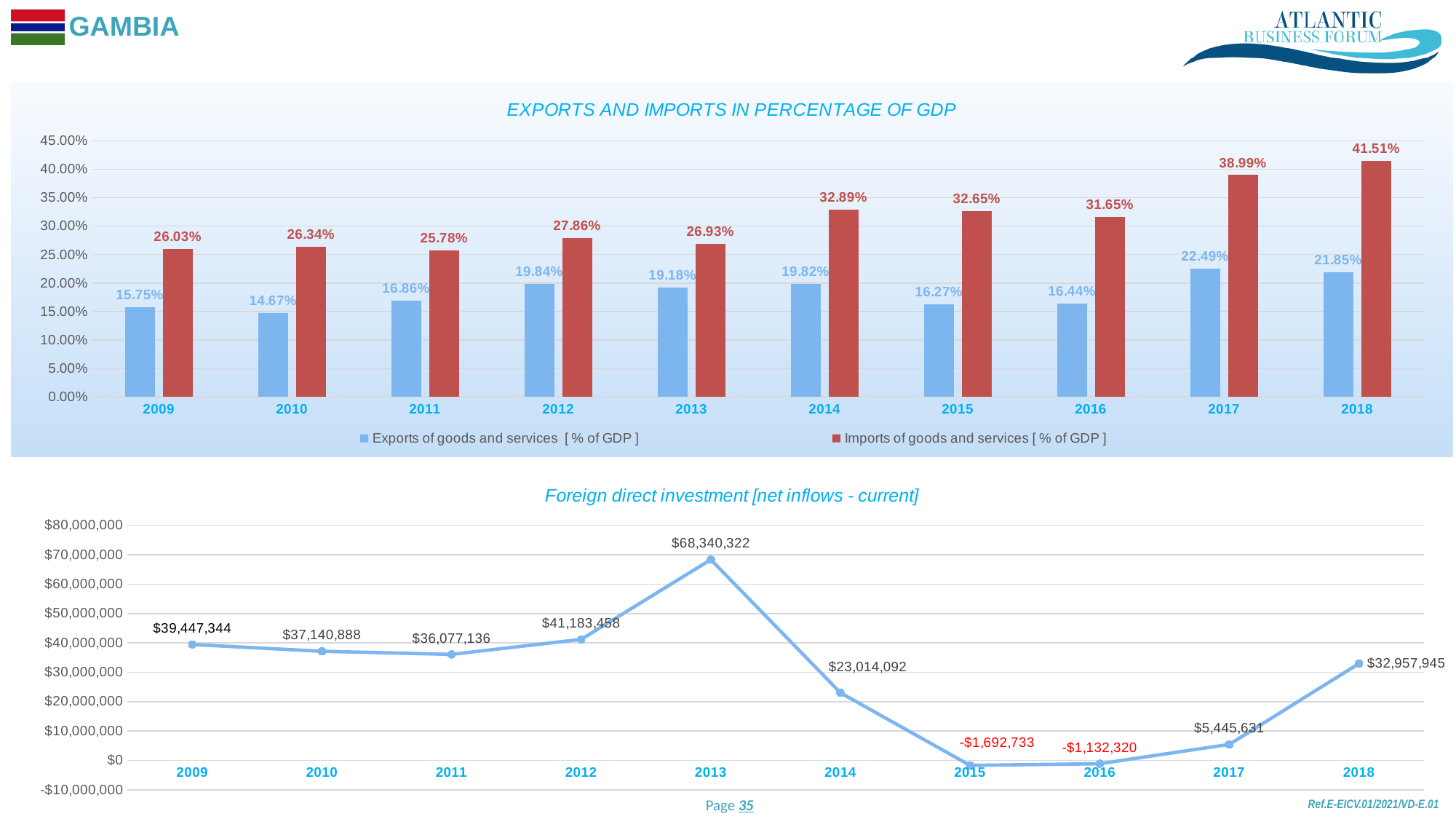
In the 'Exports and Imports in Percentage of GDP' chart, what is the value of imports of goods and services in 2017? 38.99% In the 'Foreign direct investment [net inflows - current]' chart, what is the value for 2013? $68,340,322 In the 'Foreign direct investment [net inflows - current]' chart, which year has the lowest value? 2015 In the 'Exports and Imports in Percentage of GDP' chart, which year has the highest imports value? 2018 What kind of chart is the 'Foreign direct investment [net inflows - current]' chart? Line chart In the 'Foreign direct investment [net inflows - current]' chart, is the value for 2014 larger or smaller than the value for 2018? Smaller In the 'Exports and Imports in Percentage of GDP' chart, how many series does the legend list? 2 In the 'Exports and Imports in Percentage of GDP' chart, what is the value of exports of goods and services in 2012? 19.84% In the 'Foreign direct investment [net inflows - current]' chart, how many years are plotted? 10 In the 'Exports and Imports in Percentage of GDP' chart, what is the difference between imports and exports in 2018? 19.66% What kind of chart is the 'Exports and Imports in Percentage of GDP' chart? Bar chart In the 'Exports and Imports in Percentage of GDP' chart, which year has the lowest exports value? 2010